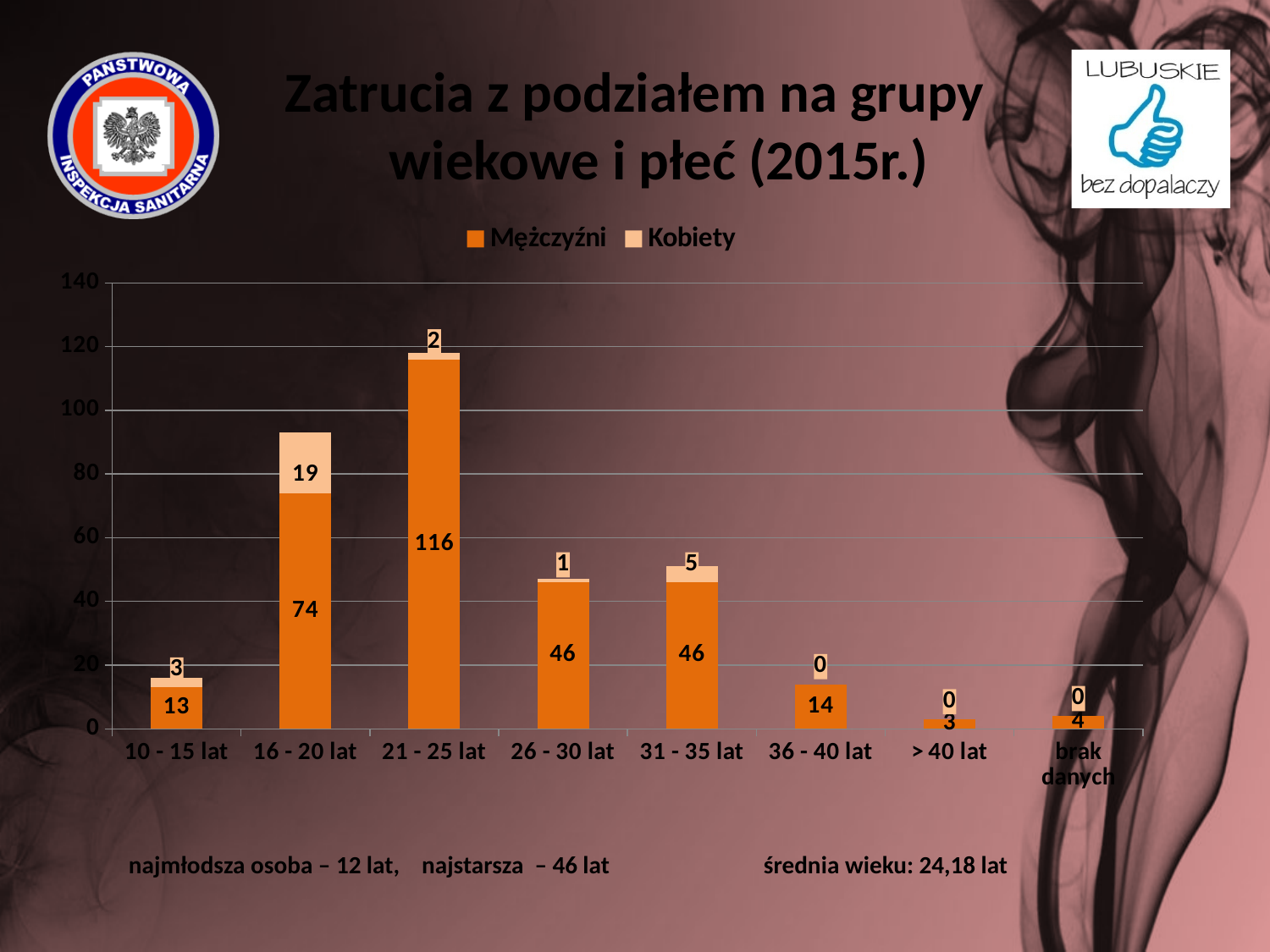
What is the Mężczyźni value for the 21 - 25 lat age group? 116 Which age group has the lowest Mężczyźni value? > 40 lat What is the Kobiety value for the 16 - 20 lat age group? 19 What is the difference between the Mężczyźni values for 21 - 25 lat and 16 - 20 lat? 42 Which age group has the highest Kobiety value? 16 - 20 lat How many series does the legend list? 2 Which age group has the highest Mężczyźni value? 21 - 25 lat How many age-group categories are shown on the x axis? 8 What kind of chart is shown on the slide? Stacked bar chart What is the total of the stacked bar for the 16 - 20 lat age group? 93 What is the Mężczyźni value for the 36 - 40 lat age group? 14 Which is larger, the Kobiety value for 31 - 35 lat or for 26 - 30 lat? 31 - 35 lat